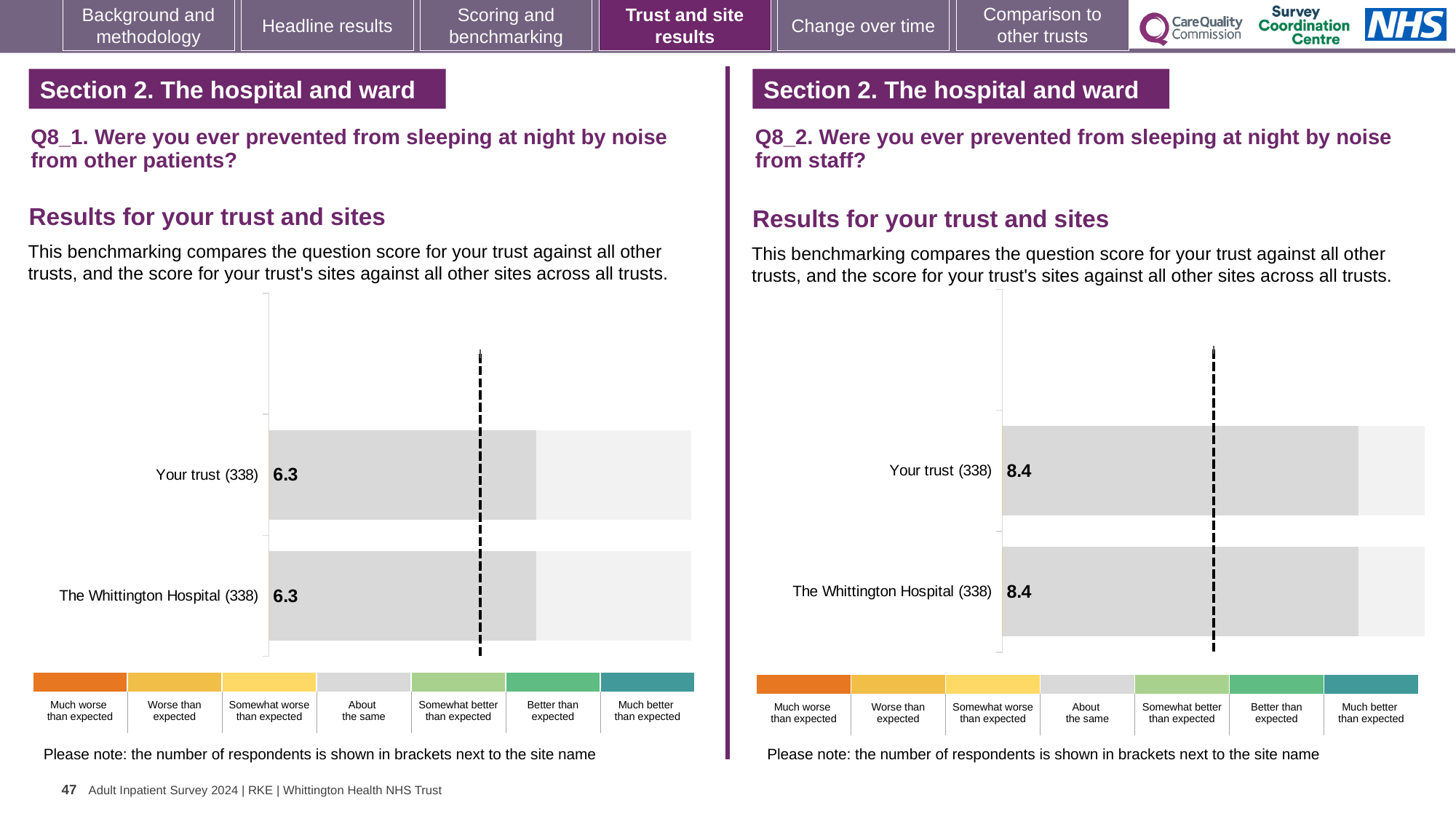
In the Q8_1 chart (left), what is the score for Your trust? 6.3 What is the label of the second bar in the Q8_2 chart (right)? The Whittington Hospital (338) In the Q8_1 chart (left), how many respondents are shown in brackets next to Your trust? 338 In the Q8_1 chart (left), what is the score for The Whittington Hospital? 6.3 In the Q8_2 chart (right), what is the score for Your trust? 8.4 In the Q8_1 chart (left), what is the difference between the score for Your trust and the score for The Whittington Hospital? 0 How many rating categories does the colour key below the Q8_1 chart (left) list? 7 What kind of chart is used for the Q8_2 results (right)? Bar chart In the Q8_2 chart (right), what is the difference between the score for Your trust and the score for The Whittington Hospital? 0 How many bars are plotted in the Q8_1 chart (left)? 2 In the Q8_2 chart (right), what is the score for The Whittington Hospital? 8.4 How many bars are plotted in the Q8_2 chart (right)? 2